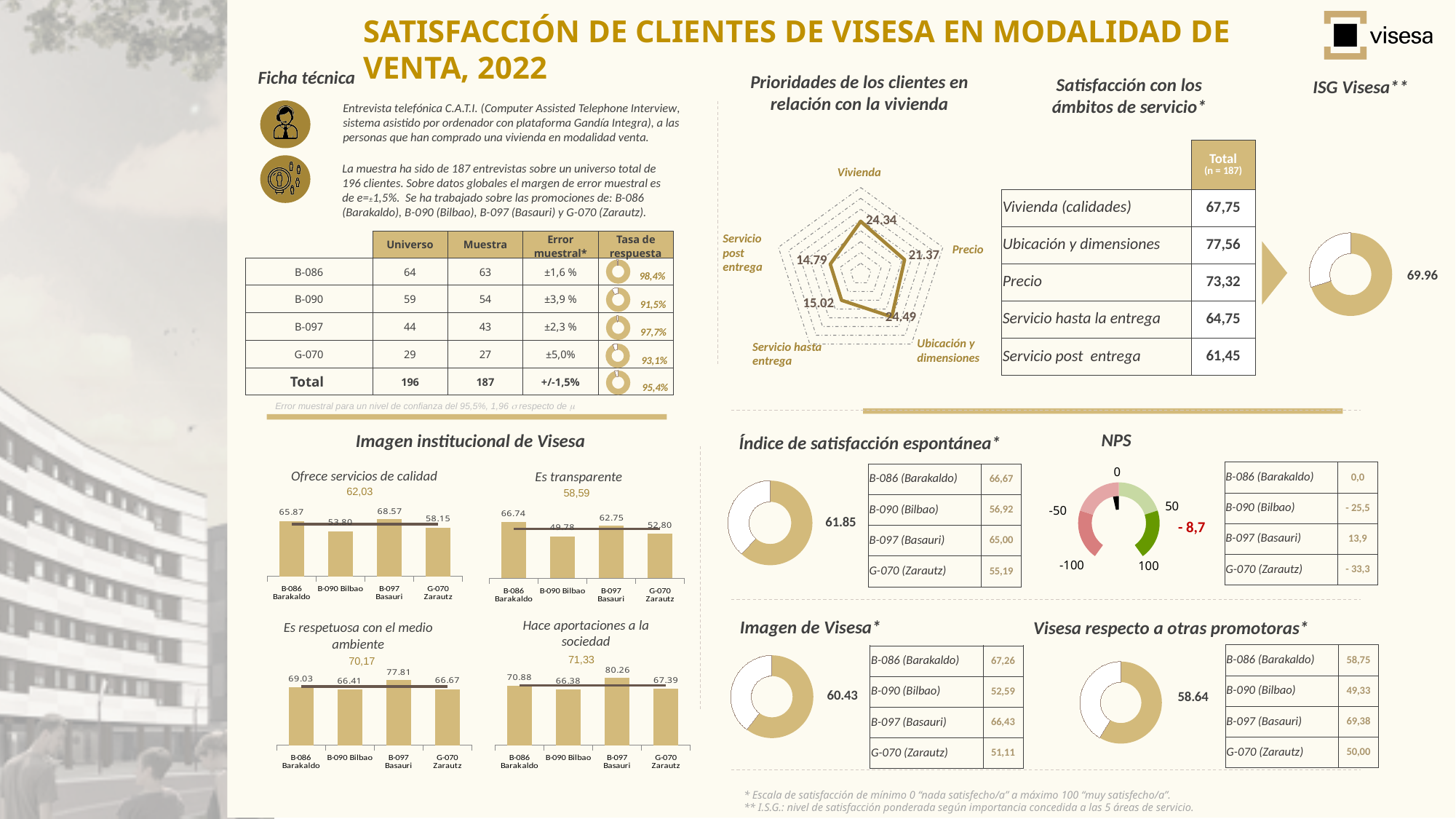
What value is shown next to the donut chart under 'ISG Visesa'? 69.96 What kind of chart is 'Prioridades de los clientes en relación con la vivienda'? Radar chart How many categories (axes) does the radar chart 'Prioridades de los clientes en relación con la vivienda' have? 5 What value does the NPS gauge chart show? - 8,7 In the radar chart 'Prioridades de los clientes en relación con la vivienda', what is the value for Precio? 21.37 How many promotions (bars) are shown in the bar chart 'Hace aportaciones a la sociedad'? 4 In the bar chart 'Es transparente', which is larger: the value for B-086 Barakaldo or for B-097 Basauri? B-086 Barakaldo In the radar chart 'Prioridades de los clientes en relación con la vivienda', which category has the lowest value? Servicio post entrega In the bar chart 'Es respetuosa con el medio ambiente', what is the difference between the values for B-097 Basauri and B-090 Bilbao? 11.40 In the bar chart 'Ofrece servicios de calidad', which promotion has the highest value? B-097 Basauri In the bar chart 'Hace aportaciones a la sociedad', what is the highest value shown? 80.26 In the bar chart 'Es transparente', what is the value for B-090 Bilbao? 49.78